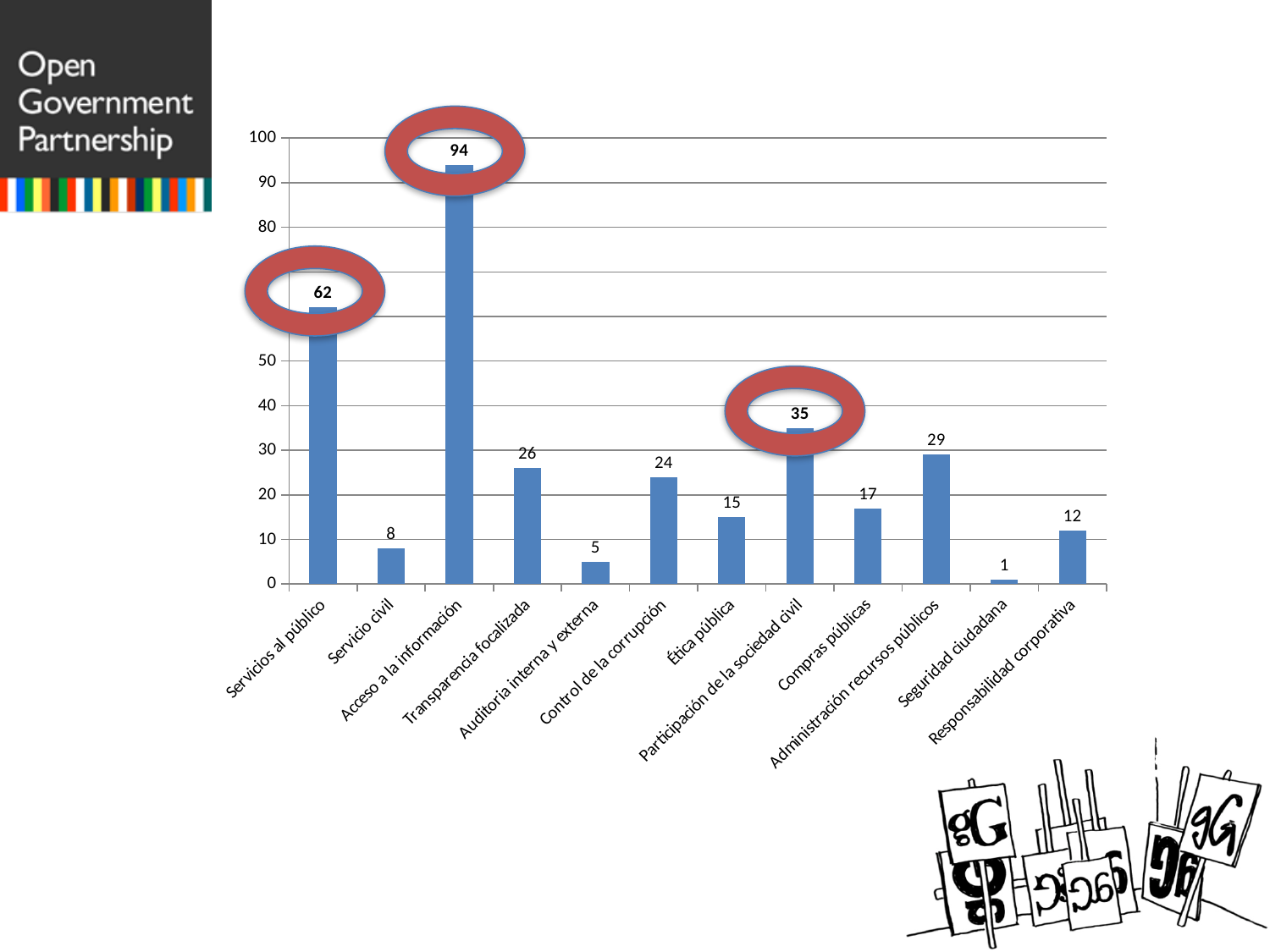
Which is larger, the value for Transparencia focalizada or the value for Control de la corrupción? Transparencia focalizada Which category has the lowest value? Seguridad ciudadana What is the value for Acceso a la información? 94 What is the value for Participación de la sociedad civil? 35 What is the difference between the values for Acceso a la información and Servicios al público? 32 Which category has the highest value? Acceso a la información What kind of chart is shown on the slide? bar chart How many bars are highlighted with red circles? 3 What is the value for Administración recursos públicos? 29 How many categories are shown on the x axis? 12 What is the value for Servicios al público? 62 Is the value for Ética pública greater or less than 20? less